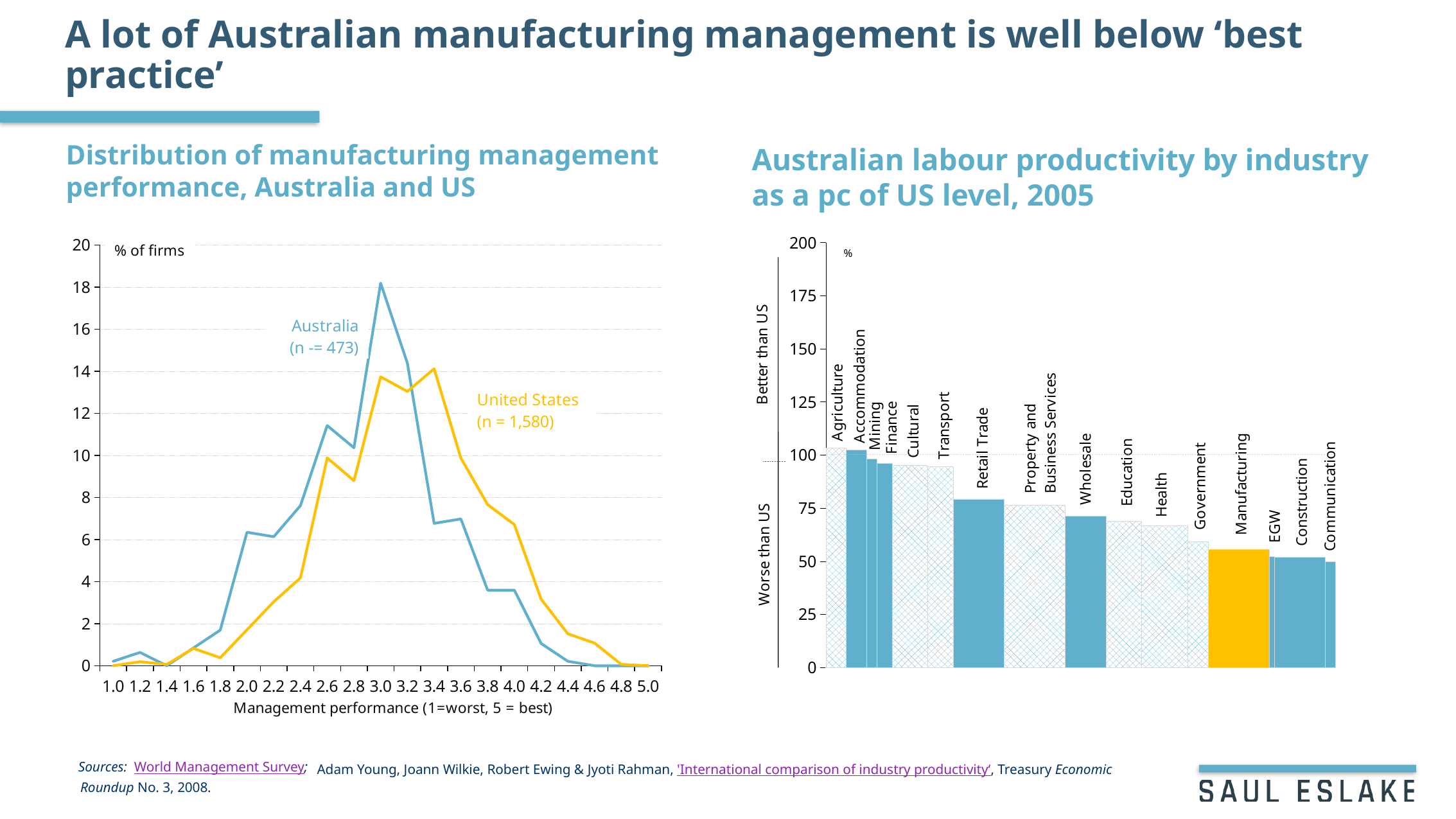
On the right chart, 'Australian labour productivity by industry', which is larger, the value for Retail Trade or the value for Manufacturing? Retail Trade On the right chart, 'Australian labour productivity by industry', is the value for Manufacturing greater or less than 75? less On the left chart, 'Distribution of manufacturing management performance', is the United States value at a management performance of 3.4 greater or less than 12? greater On the right chart, 'Australian labour productivity by industry', do the values generally rise or fall moving from left to right across the industries? fall On the left chart, 'Distribution of manufacturing management performance', is the Australia value at a management performance of 3.0 greater or less than 16? greater How many industries are shown on the right chart, 'Australian labour productivity by industry as a pc of US level, 2005'? 16 How many series are plotted on the left chart, 'Distribution of manufacturing management performance, Australia and US'? 2 On the left chart, 'Distribution of manufacturing management performance', what sample size is given for the United States series? n = 1,580 What kind of chart is the left chart, 'Distribution of manufacturing management performance, Australia and US'? line chart What kind of chart is the right chart, 'Australian labour productivity by industry as a pc of US level, 2005'? bar chart On the left chart, 'Distribution of manufacturing management performance', which series reaches the higher peak, Australia or United States? Australia